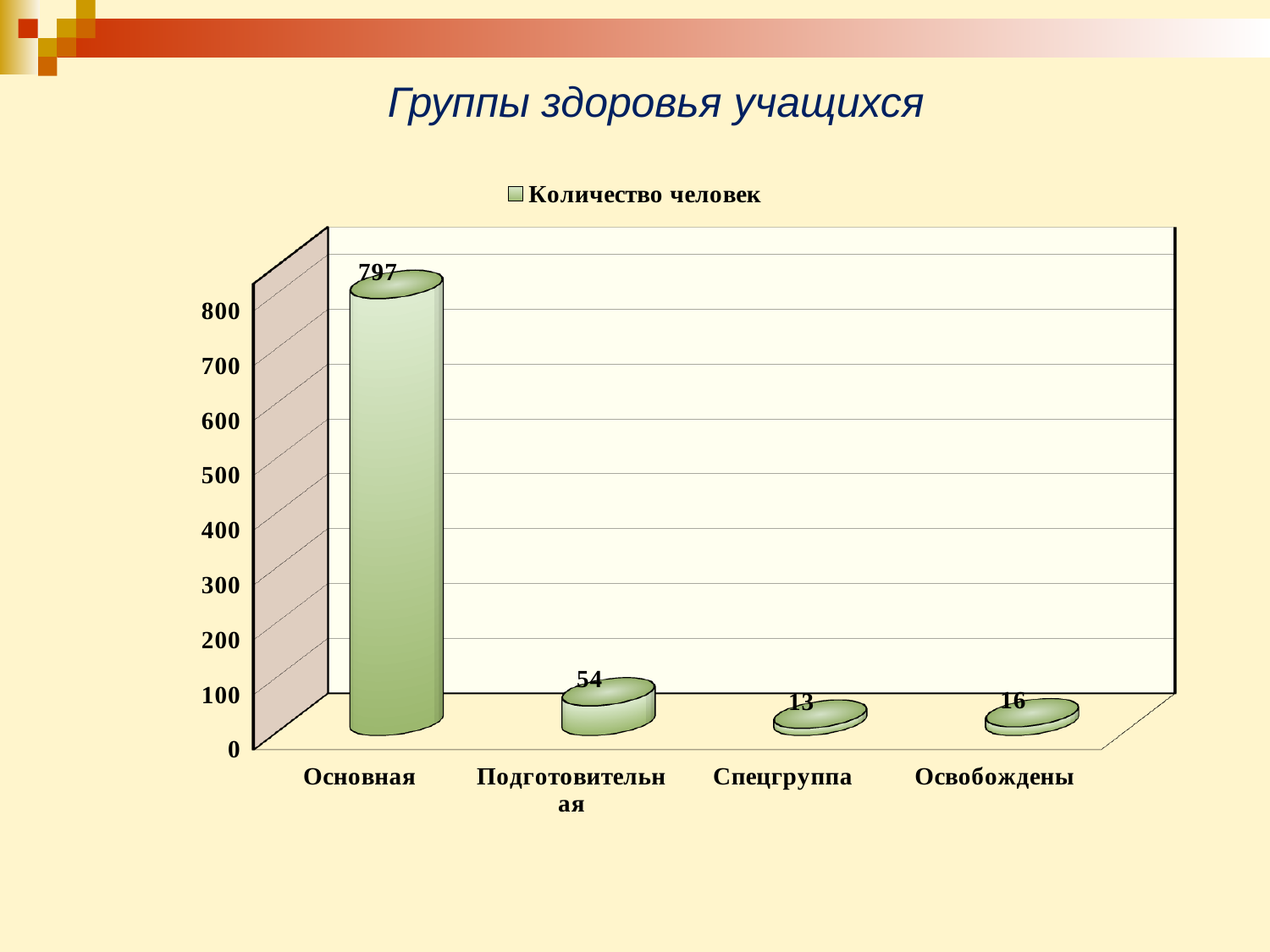
What is the value for Основная? 797 What is the value for Спецгруппа? 13 How many categories are shown on the x axis? 4 How many series does the legend list? 1 Which category has the highest value? Основная Which is larger, the value for Освобождены or the value for Спецгруппа? Освобождены What is the difference between the values for Основная and Подготовительная? 743 What kind of chart is shown on the slide? Bar chart What is the legend entry of the series shown? Количество человек What is the value for Подготовительная? 54 Which category has the lowest value? Спецгруппа What is the value for Освобождены? 16